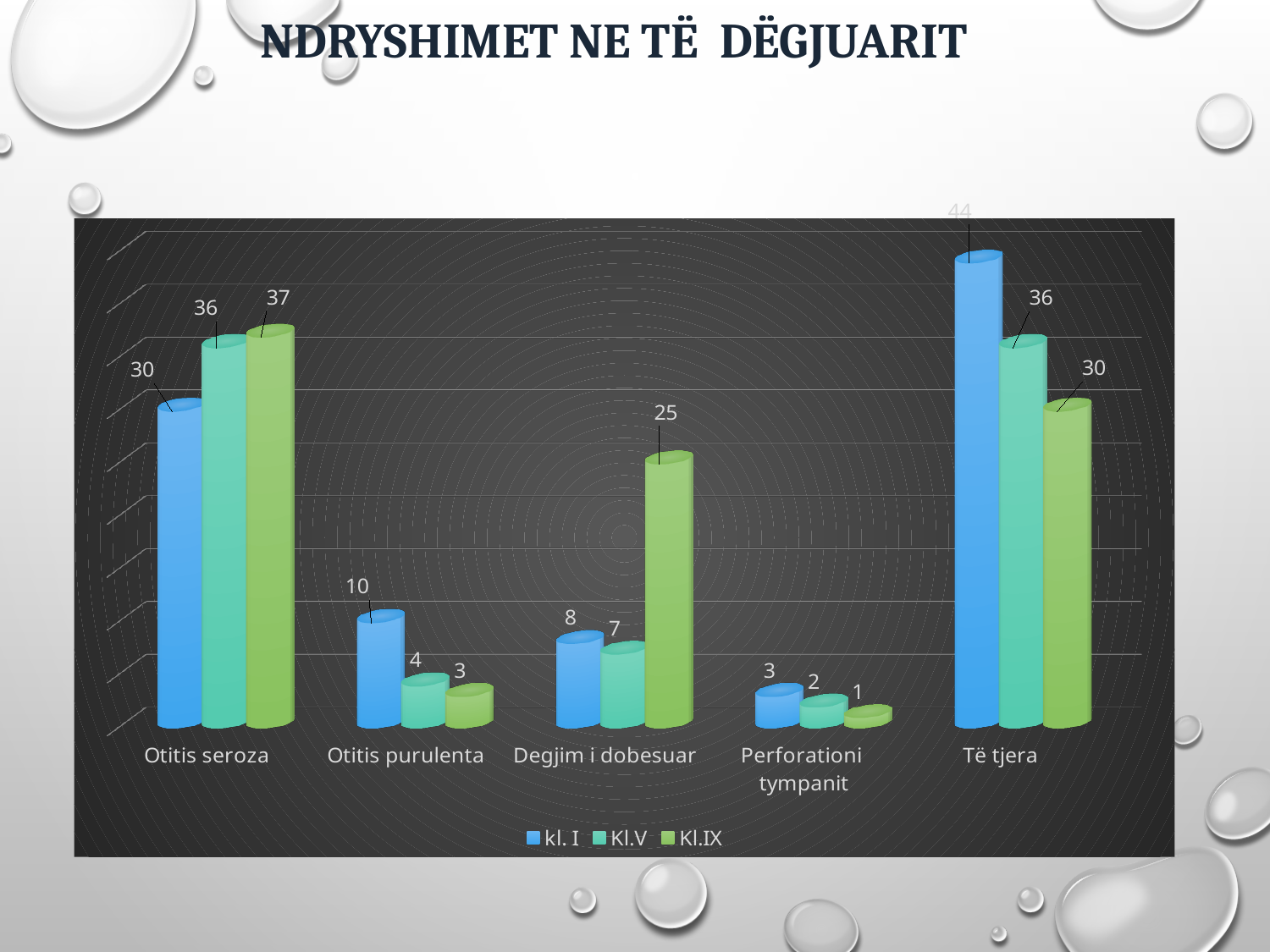
How many categories are shown on the x axis? 5 What kind of chart is shown on the slide? Bar chart Which category has the highest value for kl. I? Të tjera What is the value for kl. I in the Otitis purulenta category? 10 What is the value for Kl.V in the Të tjera category? 36 Which is larger in the Otitis seroza category: the value for kl. I or the value for Kl.IX? Kl.IX Which category has the lowest value for Kl.IX? Perforationi tympanit What is the title of the slide? NDRYSHIMET NE TË DËGJUARIT What is the value for Kl.IX in the Degjim i dobesuar category? 25 What is the difference between the kl. I and Kl.IX values in the Të tjera category? 14 What is the value for kl. I in the Otitis seroza category? 30 How many series does the legend list? 3